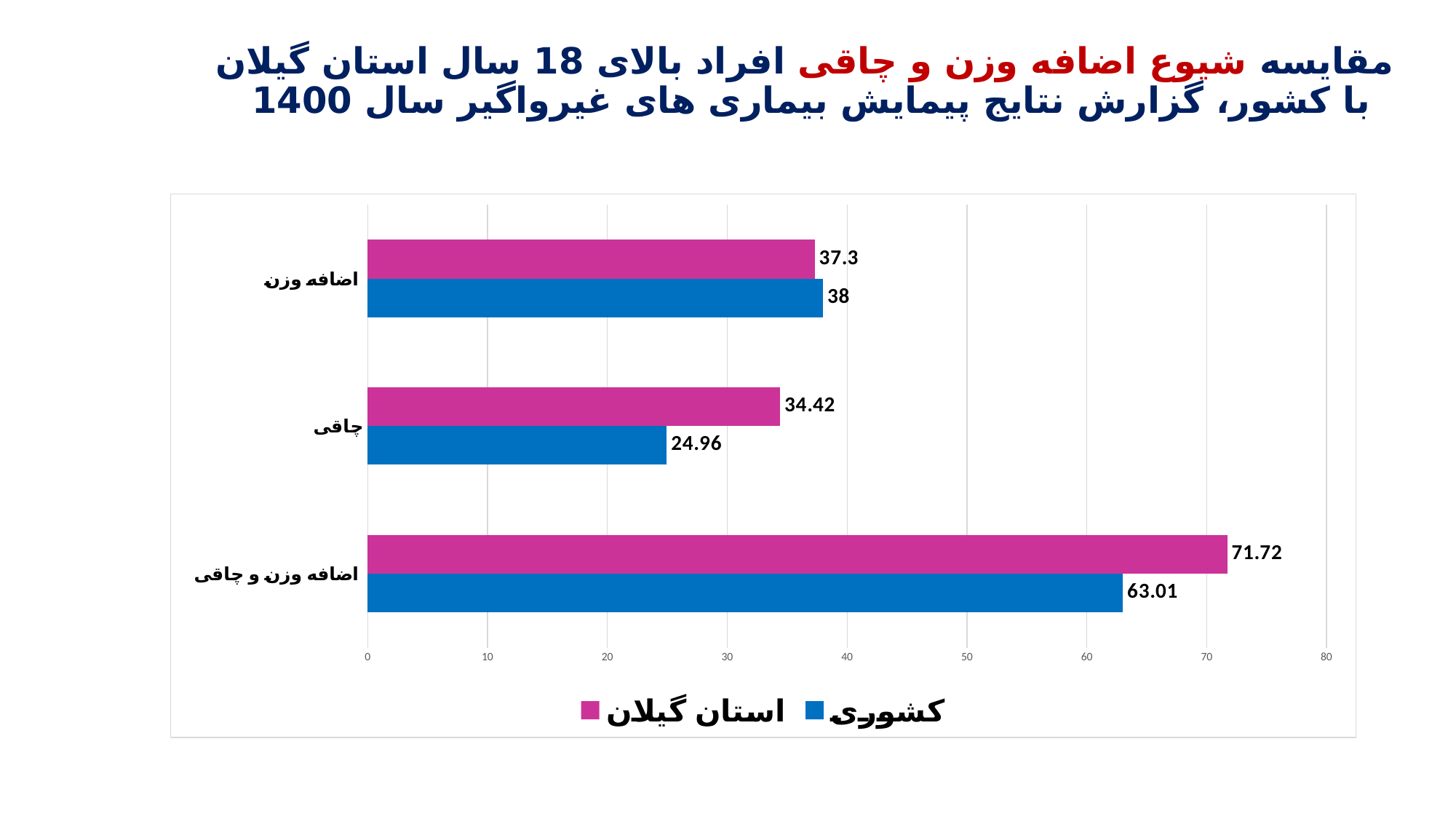
How many series does the legend list? 2 What is the value for کشوری in the اضافه وزن category? 38 What kind of chart is shown on the slide? Bar chart What is the difference between the استان گیلان and کشوری values in the اضافه وزن و چاقی category? 8.71 Which category has the highest value for the کشوری series? اضافه وزن و چاقی What is the difference between the استان گیلان and کشوری values in the چاقی category? 9.46 How many categories are shown on the chart? 3 What is the value for استان گیلان in the اضافه وزن category? 37.3 Which category has the lowest value for the استان گیلان series? چاقی In the چاقی category, which series has the larger value, استان گیلان or کشوری? استان گیلان What is the value for استان گیلان in the اضافه وزن و چاقی category? 71.72 What is the value for کشوری in the چاقی category? 24.96